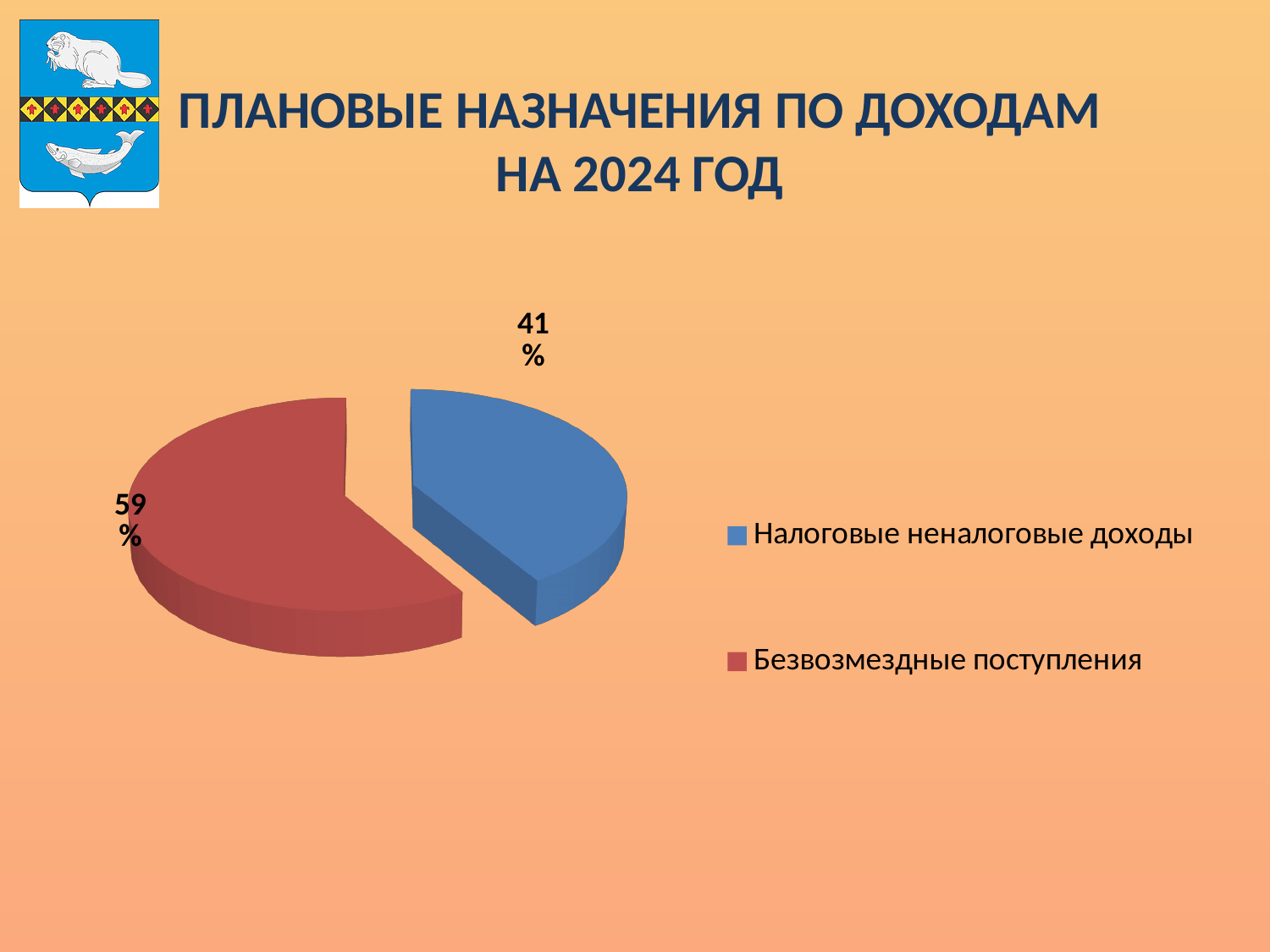
What colour is the slice for Безвозмездные поступления? Red Which is larger: Налоговые неналоговые доходы or Безвозмездные поступления? Безвозмездные поступления How many slices does the pie chart have? 2 What is the difference in percentage points between Безвозмездные поступления and Налоговые неналоговые доходы? 18 What share of the pie does Налоговые неналоговые доходы represent? 41% Which category has the largest slice of the pie? Безвозмездные поступления What is the title of the slide? ПЛАНОВЫЕ НАЗНАЧЕНИЯ ПО ДОХОДАМ НА 2024 ГОД Which category has the smallest slice of the pie? Налоговые неналоговые доходы What share of the pie does Безвозмездные поступления represent? 59% How many entries does the legend list? 2 What kind of chart is shown on the slide? Pie chart